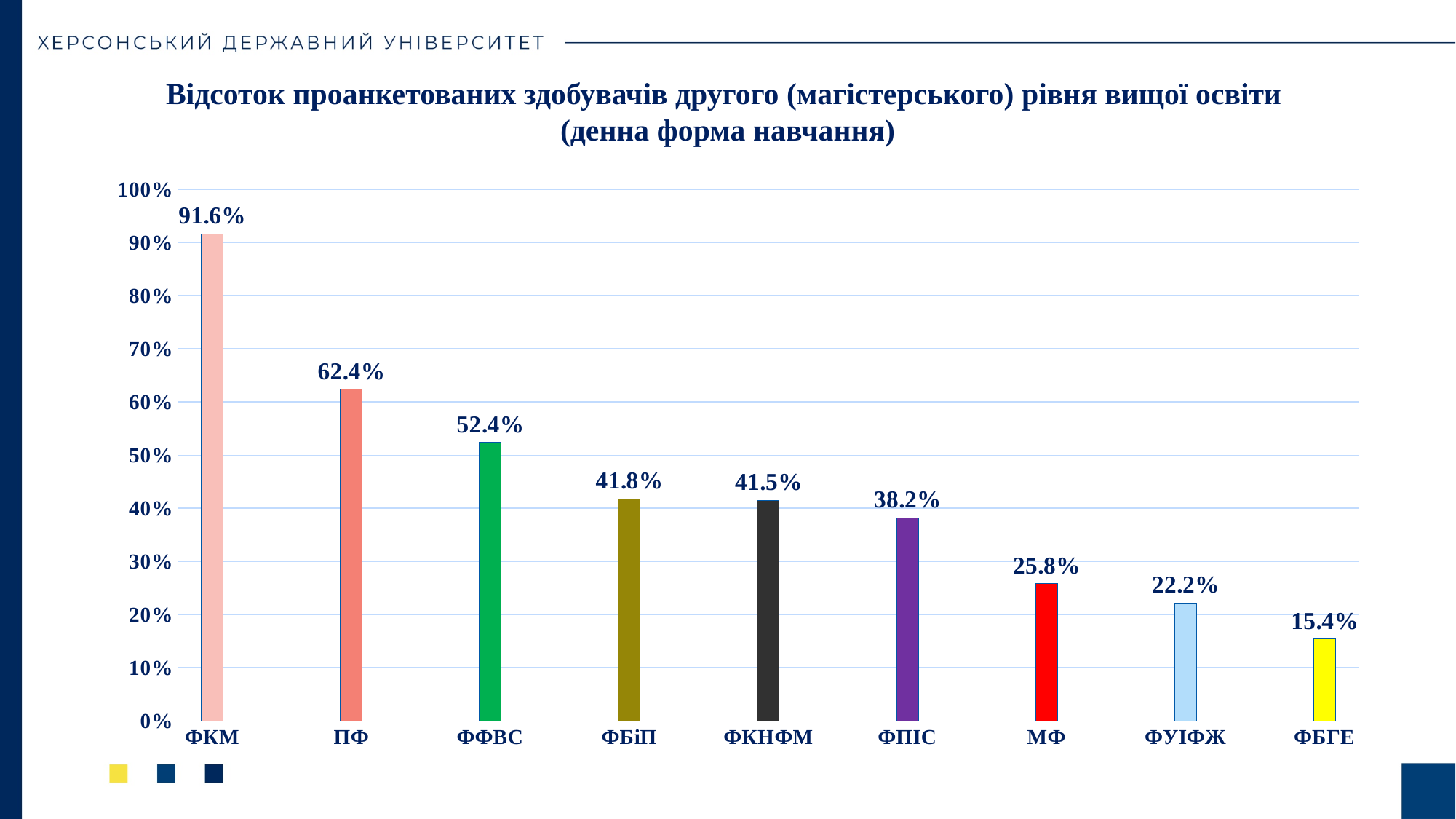
Do the values rise or fall from left to right along the x axis? fall What is the value for ФКМ? 91.6% What is the difference between the values for ФКМ and ПФ? 29.2% What is the difference between the values for МФ and ФБГЕ? 10.4% What is the value for ФУІФЖ? 22.2% Which category has the lowest value? ФБГЕ How many categories are shown on the x axis? 9 Which category has the highest value? ФКМ Which is larger, the value for ФФВС or the value for ФПІС? ФФВС What is the value for ФПІС? 38.2% What kind of chart is shown on the slide? bar chart Is the value for ПФ greater or less than 60%? greater